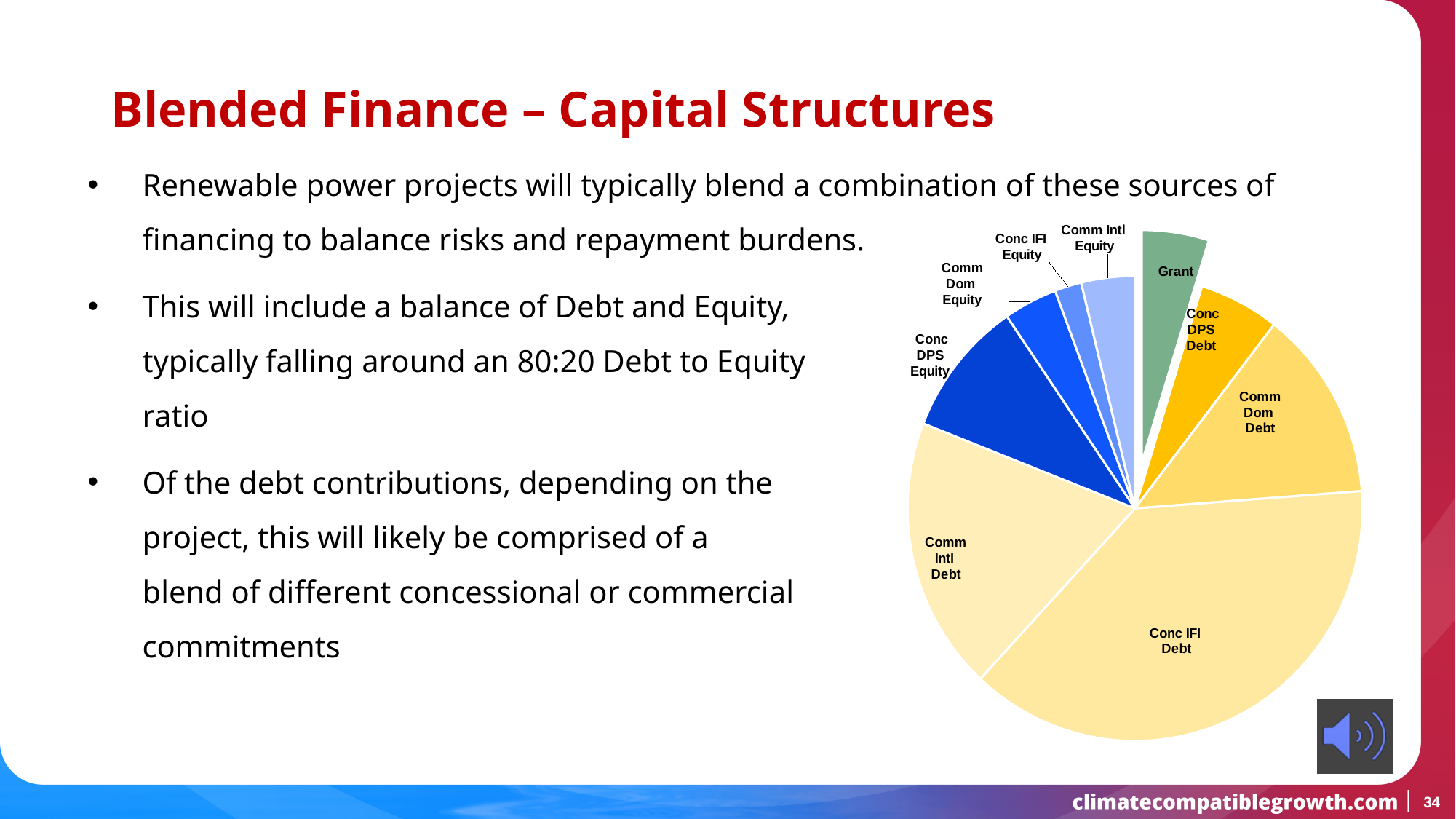
Which is larger in the pie chart, Conc IFI Debt or Comm Intl Debt? Conc IFI Debt Which is larger in the pie chart, Comm Dom Debt or Conc DPS Debt? Comm Dom Debt Which is larger in the pie chart, Conc DPS Equity or Comm Dom Equity? Conc DPS Equity Which slice of the pie chart is the smallest? Conc IFI Equity Which slice of the pie chart is pulled out (exploded) from the rest of the pie? Grant What colour is the Grant slice in the pie chart? green Which slice of the pie chart is the largest? Conc IFI Debt How many slices does the pie chart have? 9 What kind of chart is shown on the slide? pie chart